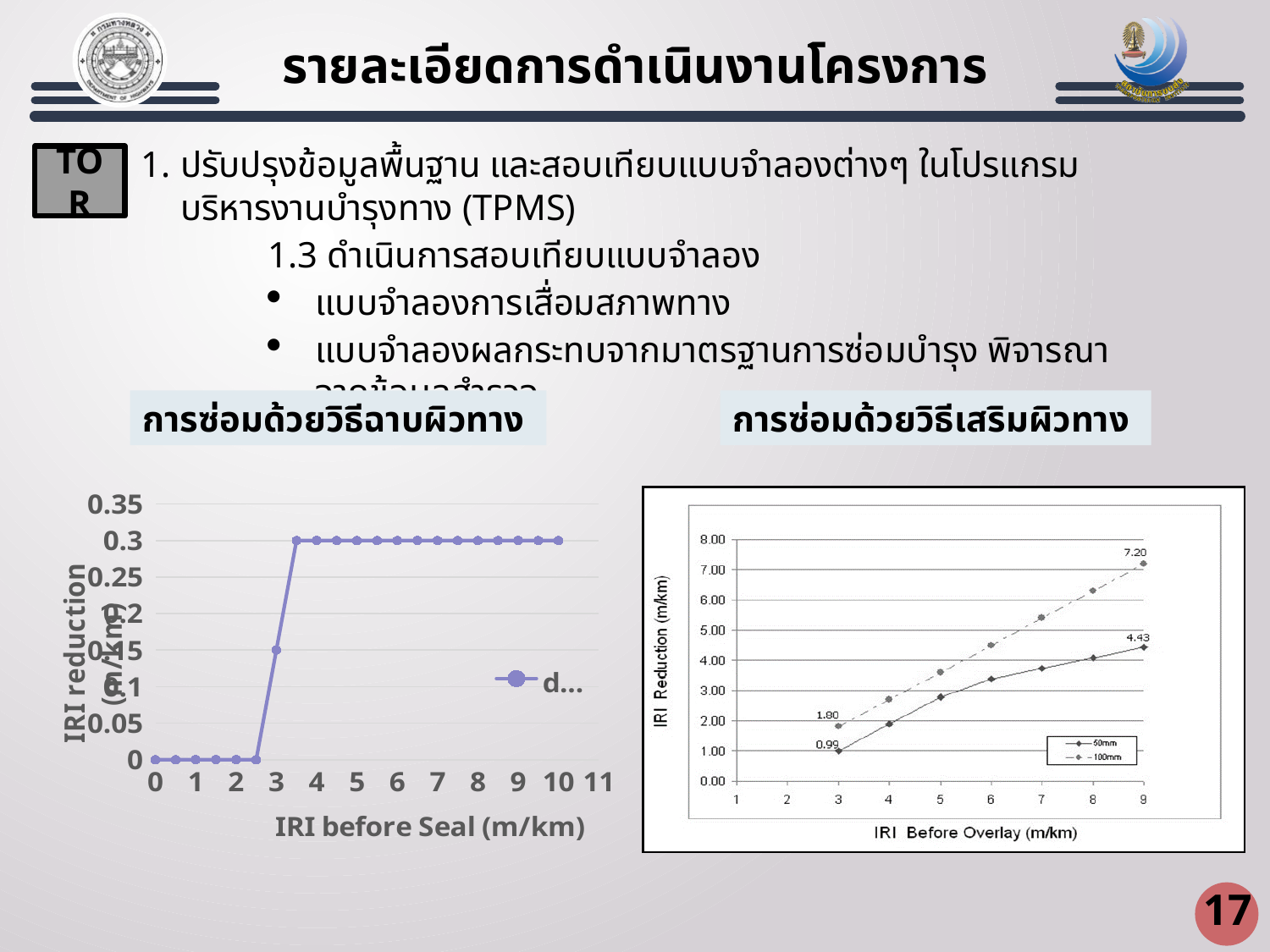
In the right chart (IRI Before Overlay), how many series does the legend list? 2 In the left chart, what is the IRI reduction when IRI before Seal is 3 m/km? 0.15 In the left chart, what is the IRI reduction when IRI before Seal is 1 m/km? 0 In the right chart, is the 50mm value at IRI Before Overlay of 5 greater or less than 3.00? less In the right chart, what is the IRI reduction for the 100mm series at IRI Before Overlay of 9? 7.20 In the right chart, what is the IRI reduction for the 50mm series at IRI Before Overlay of 3? 0.99 In the right chart, which series has the larger IRI reduction at IRI Before Overlay of 3, 50mm or 100mm? 100mm What is the x-axis label of the left chart? IRI before Seal (m/km) In the left chart, what is the IRI reduction when IRI before Seal is 10 m/km? 0.3 In the left chart, do the values rise or fall as IRI before Seal increases from 2 to 4? rise What kind of chart is the left chart (IRI before Seal)? line chart In the right chart, what is the difference between the 100mm and 50mm values at IRI Before Overlay of 9? 2.77